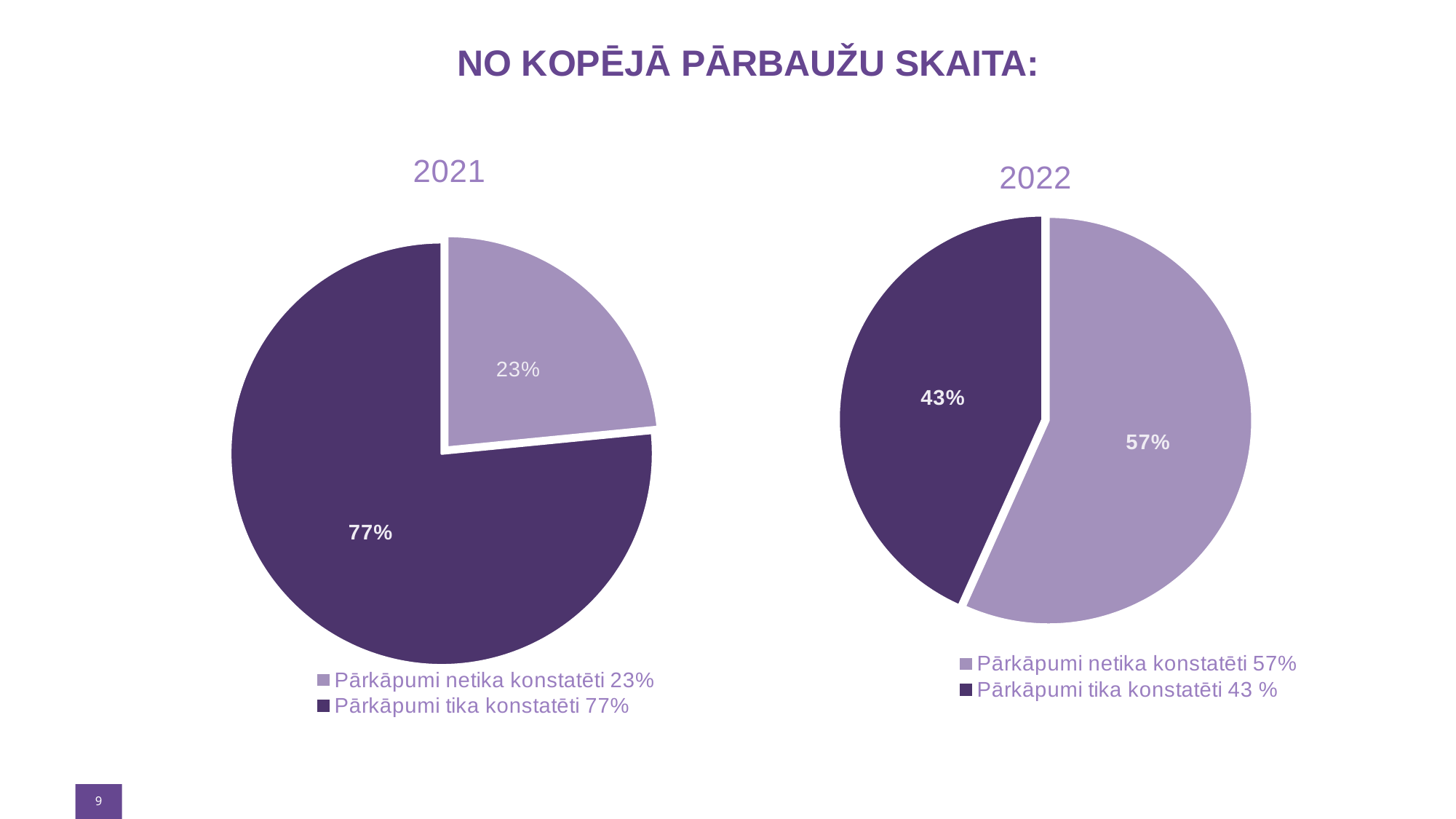
In the 2022 chart, what is the difference in percentage points between the 'Pārkāpumi netika konstatēti' slice and the 'Pārkāpumi tika konstatēti' slice? 14 In the 2021 chart, what share of the pie is labelled 'Pārkāpumi tika konstatēti'? 77% In the 2021 chart, which slice is the largest? Pārkāpumi tika konstatēti In the 2022 chart, which slice is the smallest? Pārkāpumi tika konstatēti How many slices does the 2021 pie chart have? 2 In the 2022 chart, what share of the pie is labelled 'Pārkāpumi tika konstatēti'? 43% In the 2021 chart, what share of the pie is labelled 'Pārkāpumi netika konstatēti'? 23% In the 2021 chart, what is the difference in percentage points between the 'Pārkāpumi tika konstatēti' slice and the 'Pārkāpumi netika konstatēti' slice? 54 Which is larger: the 'Pārkāpumi tika konstatēti' share in the 2021 chart or in the 2022 chart? 2021 In the 2022 chart, which colour is used for the 'Pārkāpumi netika konstatēti' slice? Light purple What kind of chart is the 2022 chart? Pie chart